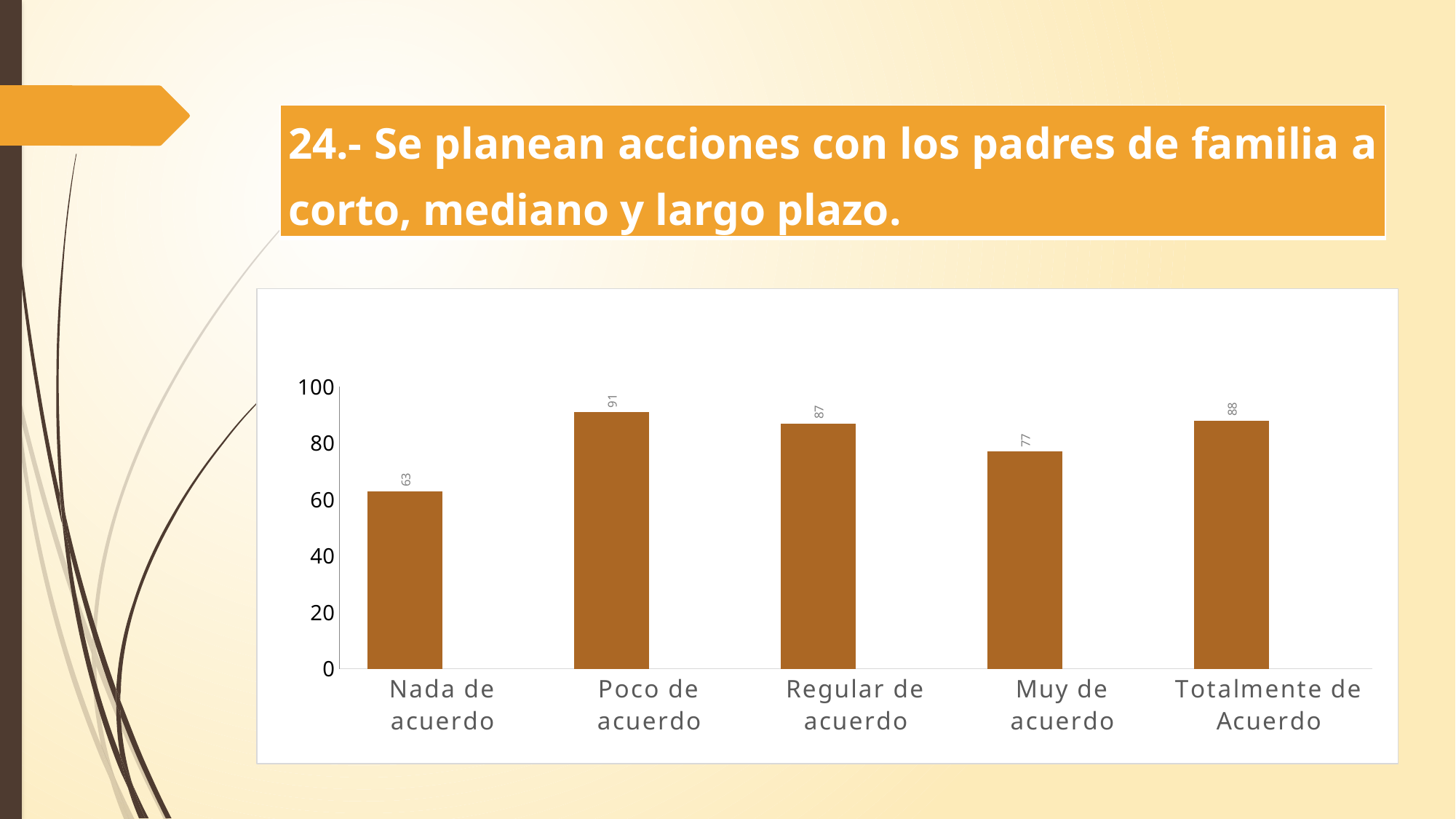
How many categories are shown on the x axis? 5 What kind of chart is shown on the slide? Bar chart Is the value for "Muy de acuerdo" greater or less than 80? less Which category has the lowest value? Nada de acuerdo What is the value for "Nada de acuerdo"? 63 What is the value for "Poco de acuerdo"? 91 What is the value for "Totalmente de Acuerdo"? 88 What is the value for "Muy de acuerdo"? 77 What is the difference between the values for "Poco de acuerdo" and "Nada de acuerdo"? 28 What is the title text shown above the chart? 24.- Se planean acciones con los padres de familia a corto, mediano y largo plazo. Which category has the highest value? Poco de acuerdo Which is larger, the value for "Regular de acuerdo" or the value for "Muy de acuerdo"? Regular de acuerdo